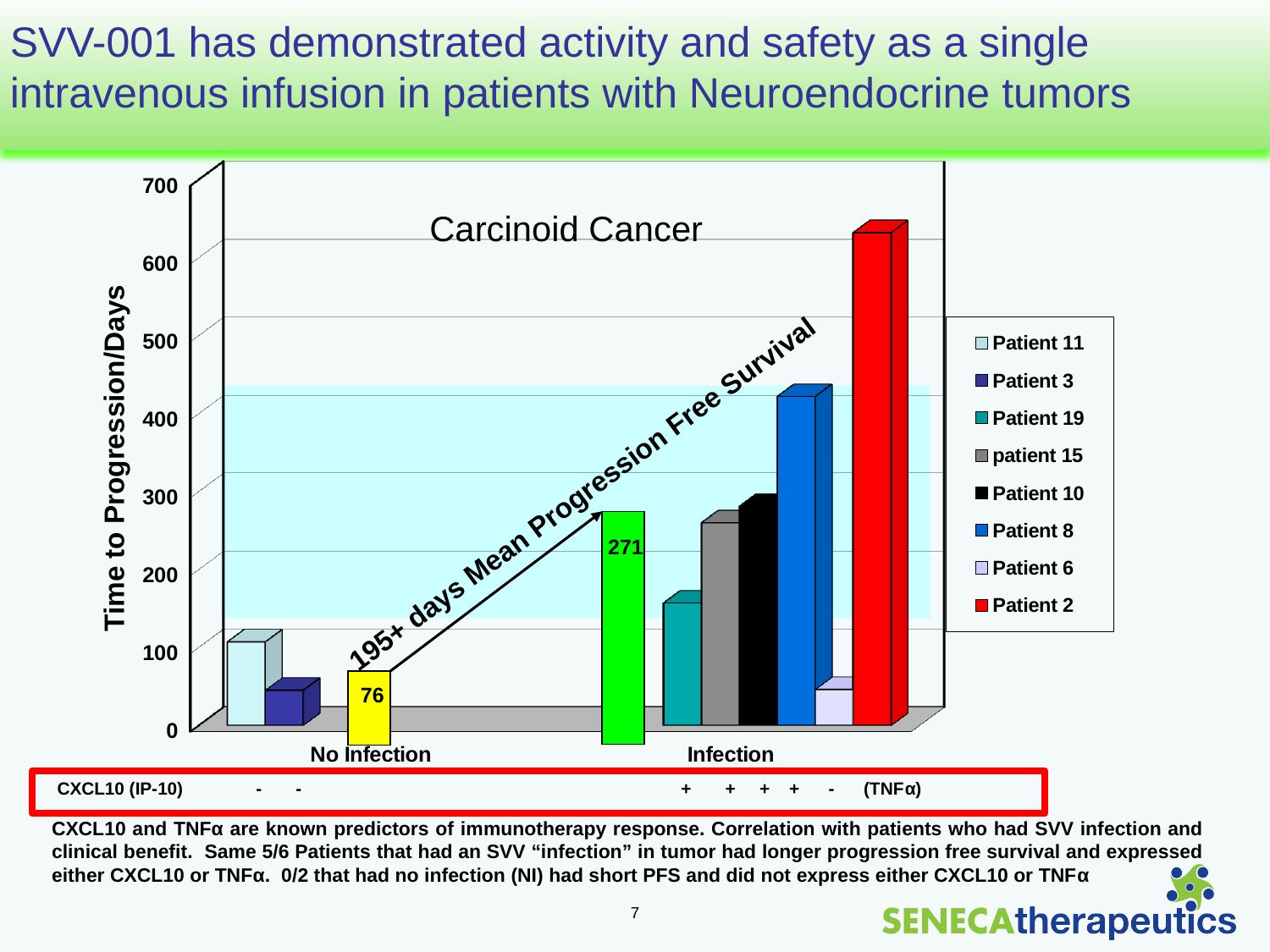
How many categories are shown on the x axis? 2 Is the value for Patient 2 greater or less than 600? greater Which patient has the highest time to progression? Patient 2 Within the Infection group, which patient has the lowest time to progression? Patient 6 What value is printed in the green box for the Infection group? 271 Is the value for Patient 8 greater or less than 300? greater What kind of chart is shown on the slide? bar chart Is the value for Patient 19 greater or less than 200? less Which is larger, the value for Patient 8 or the value for Patient 10? Patient 8 What is the title of the y axis? Time to Progression/Days How many patients does the legend list? 8 What value is printed in the yellow box for the No Infection group? 76